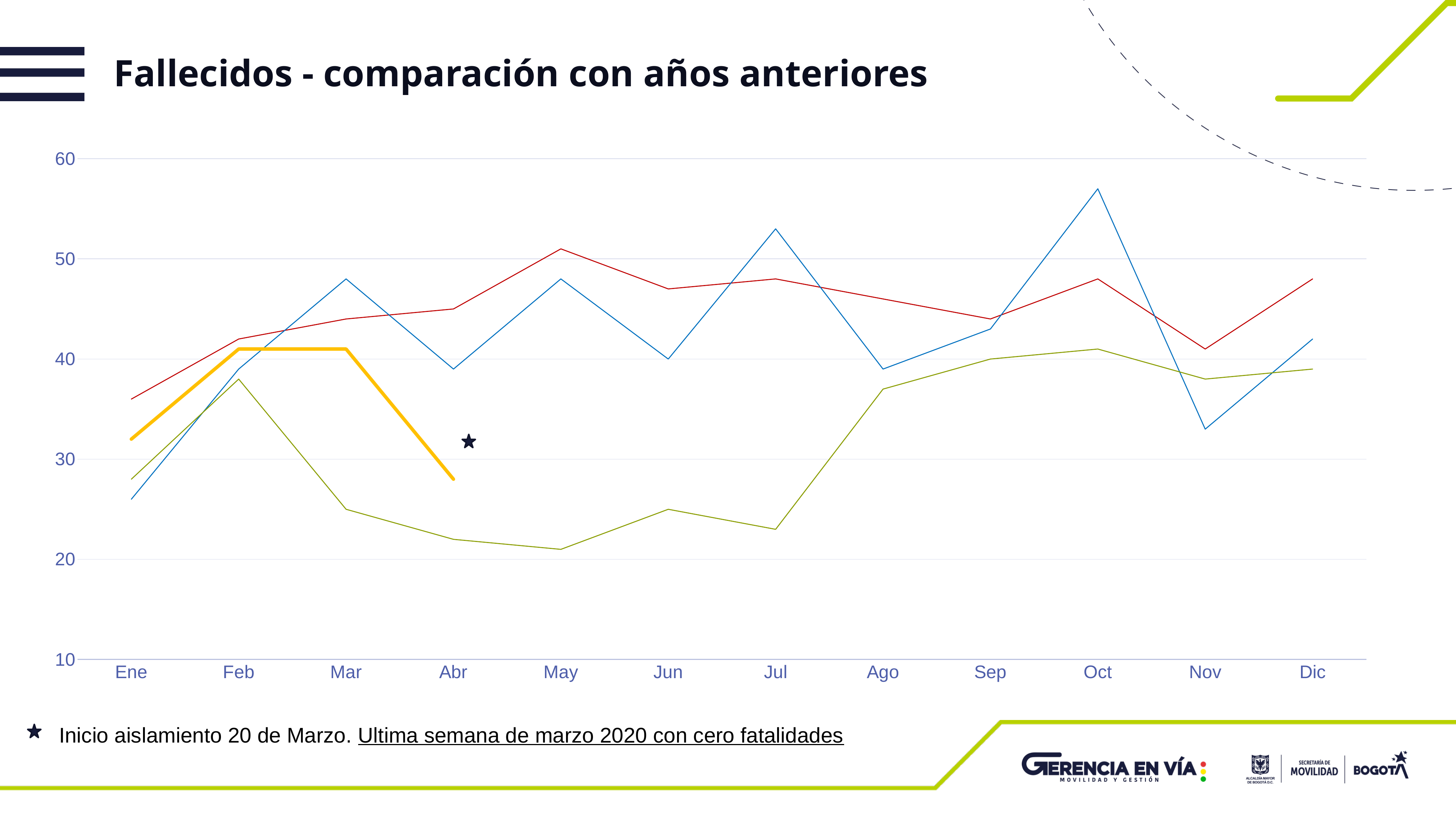
Is the value of the blue line in Oct greater or less than 50? greater In which month does the blue line reach its highest value? Oct Does the thick yellow line rise or fall from Mar to Abr? fall In which month does the blue line have its lowest value? Ene What kind of chart is shown on the slide? line chart How many months are shown along the x axis of the chart? 12 Is the value of the blue line in Mar greater or less than 40? greater What is the title of the slide's chart? Fallecidos - comparación con años anteriores Is the value of the red line in Ene greater or less than 40? less In Jul, which line is higher, the blue line or the red line? blue line